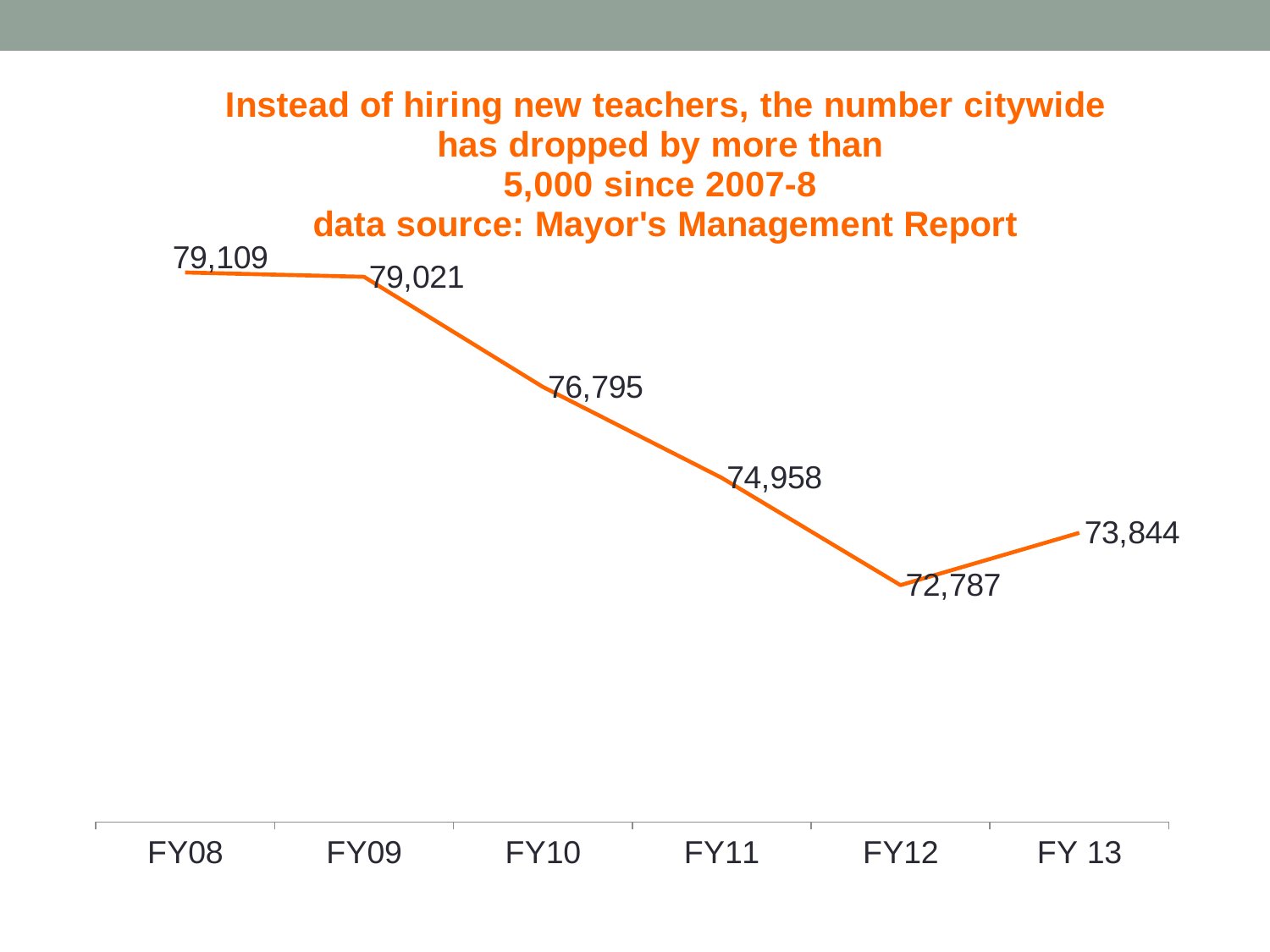
Which is larger, the value for FY11 or the value for FY 13? FY11 Which fiscal year has the lowest value? FY12 What is the difference between the values for FY08 and FY12? 6,322 How many fiscal years are plotted on the chart? 6 What is the value for FY12? 72,787 Do the values generally rise or fall from FY08 to FY12? Fall What is the difference between the values for FY11 and FY10? 1,837 What is the value for FY08? 79,109 What kind of chart is shown on the slide? Line chart Which fiscal year has the highest value? FY08 What is the value for FY10? 76,795 What is the value for FY 13? 73,844